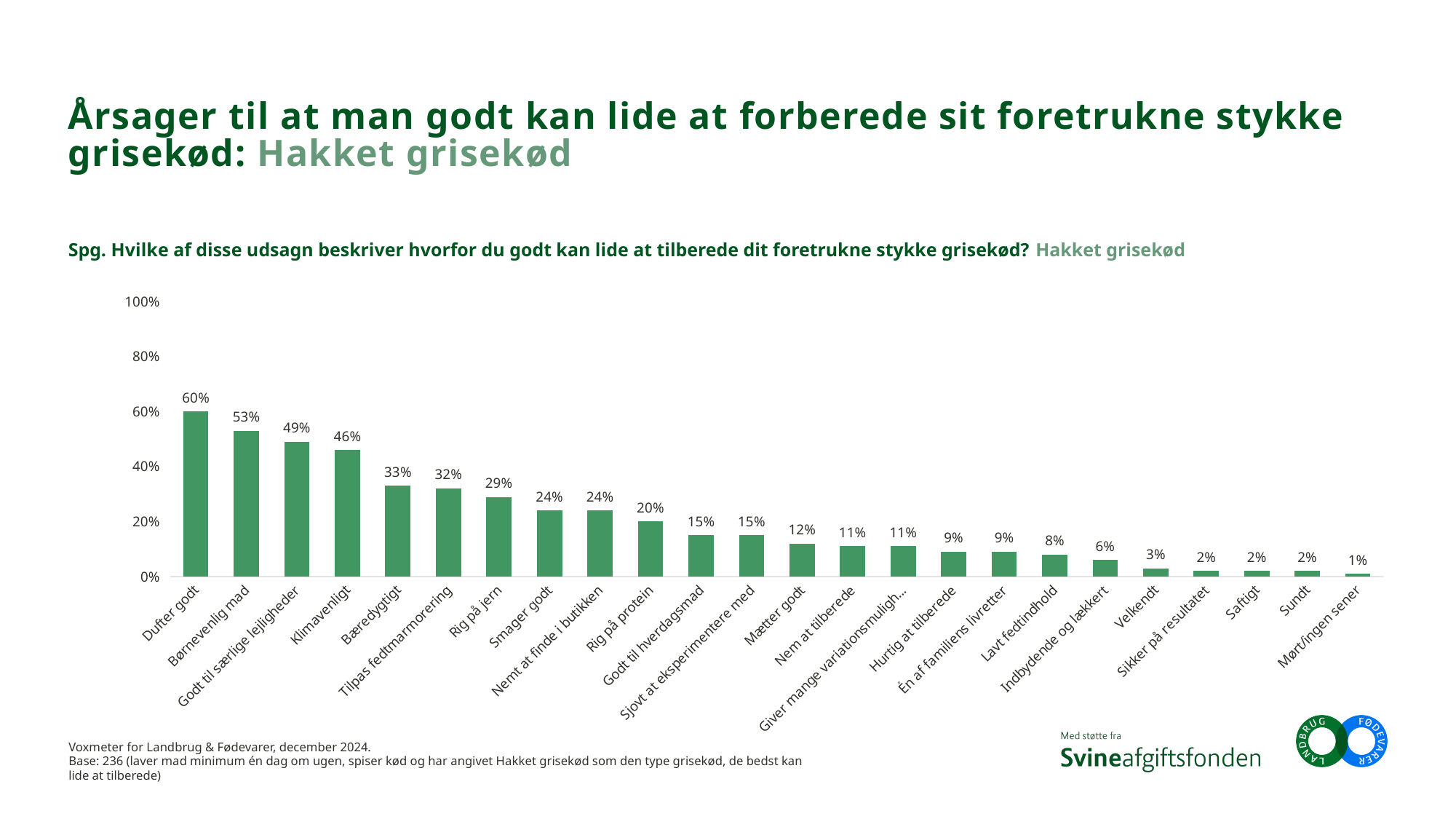
What is the difference between Dufter godt and Børnevenlig mad? 7% What is the value for Rig på protein? 20% How many categories are shown in the chart? 24 What is the difference between Smager godt and Velkendt? 21% What is the value for Klimavenligt? 46% What is the value for Lavt fedtindhold? 8% Which category has the highest value? Dufter godt What is the value for Dufter godt? 60% Do the values rise or fall from left to right along the x axis? Fall What kind of chart is shown on the slide? Bar chart Which category has the lowest value? Mørt/ingen sener Which is larger, Bæredygtigt or Rig på jern? Bæredygtigt